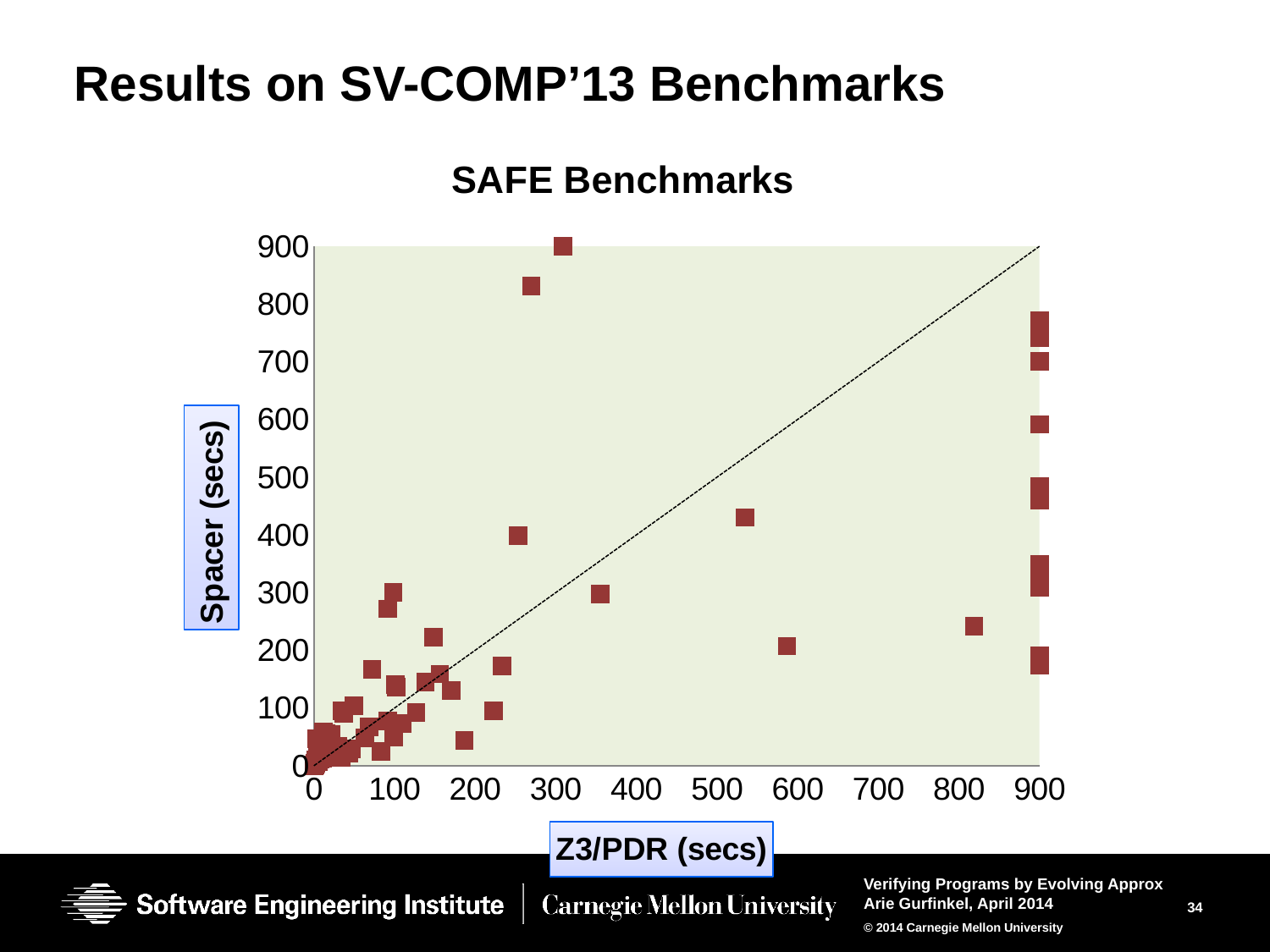
Are the points plotted at the far right edge of the chart (Z3/PDR of 900) mostly above or below the dashed diagonal line? below What kind of chart is shown on the slide? Scatter chart What is the title of the chart? SAFE Benchmarks For the point plotted at roughly 820 on the Z3/PDR axis, is its Spacer value greater or less than 300? less For the point plotted at roughly 590 on the Z3/PDR axis, is its Spacer value greater or less than 300? less What are the labels of the x axis and the y axis of the chart? Z3/PDR (secs) and Spacer (secs) Is the highest Spacer (secs) value plotted on the chart greater or less than 800? greater